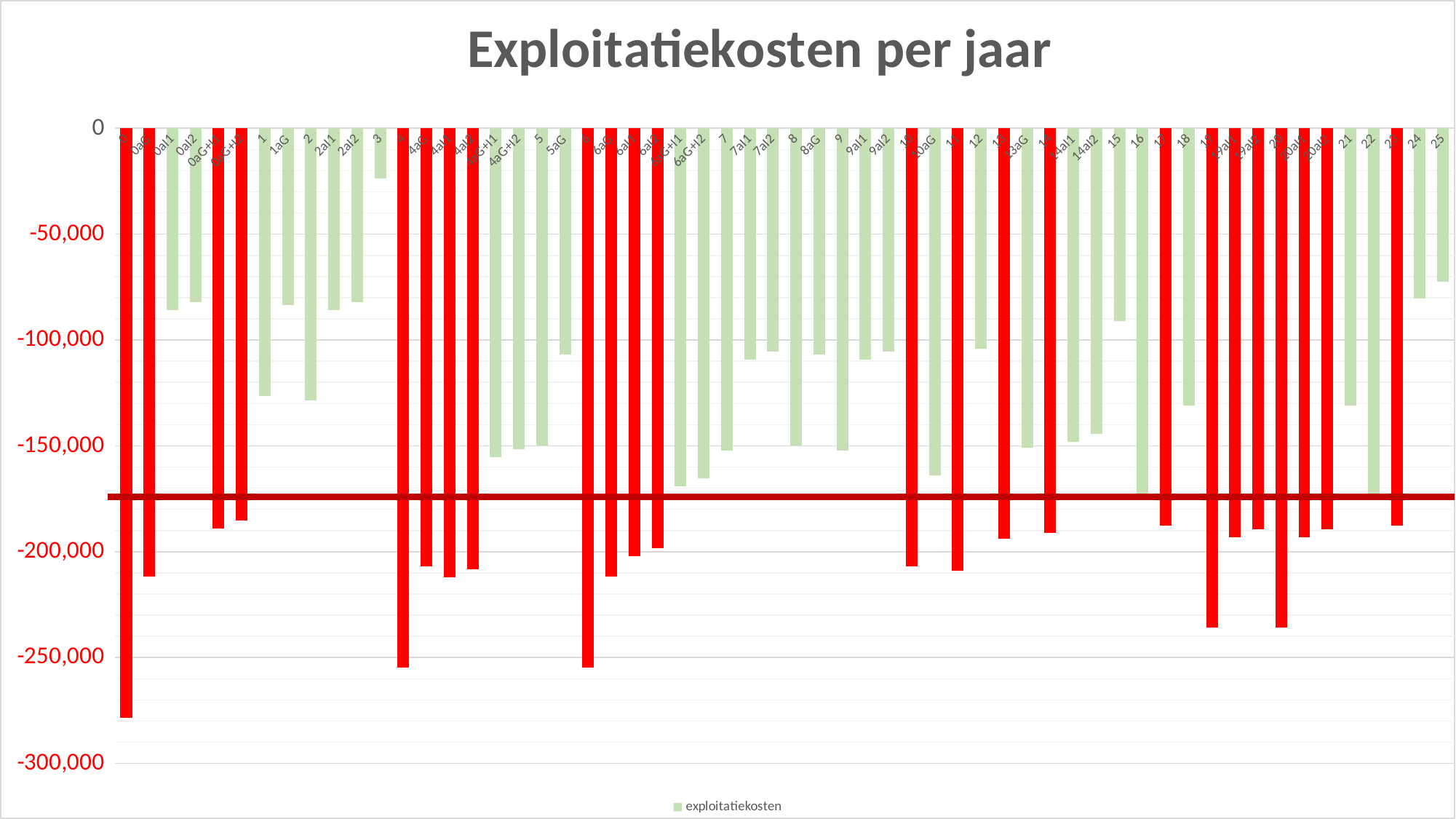
What kind of chart is shown on the slide? bar chart Is the value for category 1 greater or less than -100,000? less Which has the higher value (closer to 0), category 1 or category 3? 3 Is the value for category 0 greater or less than -250,000? less How many series does the legend list? 1 What is the title of the chart? Exploitatiekosten per jaar Which has the lower (more negative) value, category 0 or category 4? 0 Which category has the highest value (closest to 0)? 3 Is the value for category 3 greater or less than -50,000? greater Which category has the lowest (most negative) value? 0 What is the name of the series listed in the legend? exploitatiekosten